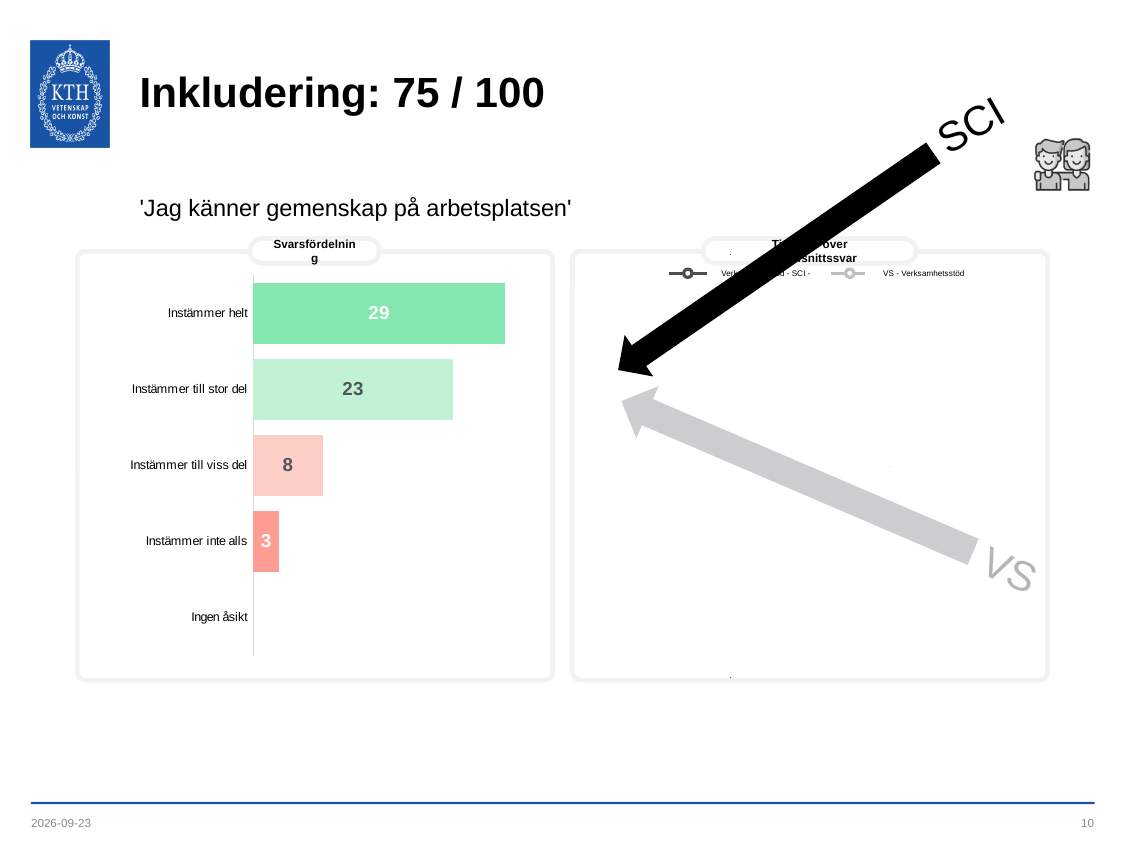
In the 'Svarsfördelning' chart, what is the value for 'Instämmer till stor del'? 23 What kind of chart is the 'Svarsfördelning' chart? Bar chart In the 'Svarsfördelning' chart, among the categories with a bar shown, which has the lowest value? Instämmer inte alls In the 'Svarsfördelning' chart, what is the difference between 'Instämmer helt' and 'Instämmer till stor del'? 6 In the 'Svarsfördelning' chart, what is the value for 'Instämmer helt'? 29 In the 'Svarsfördelning' chart, what is the value for 'Instämmer inte alls'? 3 In the 'Svarsfördelning' chart, which category has the highest value? Instämmer helt What is the title of the slide? Inkludering: 75 / 100 In the 'Svarsfördelning' chart, which is larger: 'Instämmer till viss del' or 'Instämmer inte alls'? Instämmer till viss del How many categories are listed on the vertical axis of the 'Svarsfördelning' chart? 5 In the 'Svarsfördelning' chart, what is the difference between 'Instämmer till stor del' and 'Instämmer till viss del'? 15 In the 'Svarsfördelning' chart, what is the value for 'Instämmer till viss del'? 8